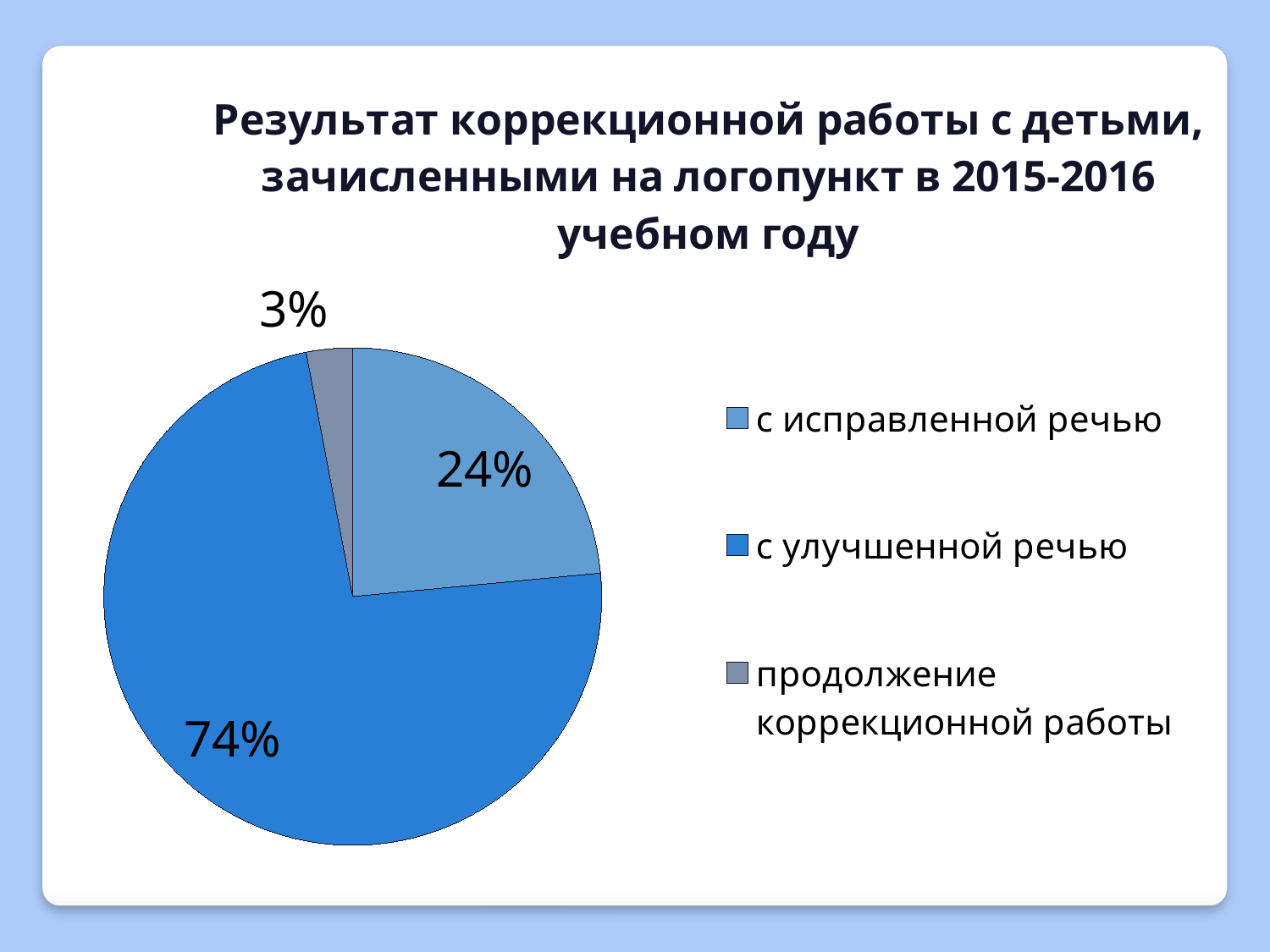
Which category has the largest share of the pie? с улучшенной речью What share of the pie does "с исправленной речью" represent? 24% How many categories does the pie chart show? 3 Which is larger: the share for "с исправленной речью" or for "продолжение коррекционной работы"? с исправленной речью How many entries does the legend list? 3 What is the difference in percentage points between "с исправленной речью" and "продолжение коррекционной работы"? 21 What share of the pie does "с улучшенной речью" represent? 74% Which category has the smallest share of the pie? продолжение коррекционной работы What type of chart is shown on the slide? pie chart What share of the pie does "продолжение коррекционной работы" represent? 3% What is the difference in percentage points between "с улучшенной речью" and "с исправленной речью"? 50 Which academic year does the chart title refer to? 2015-2016